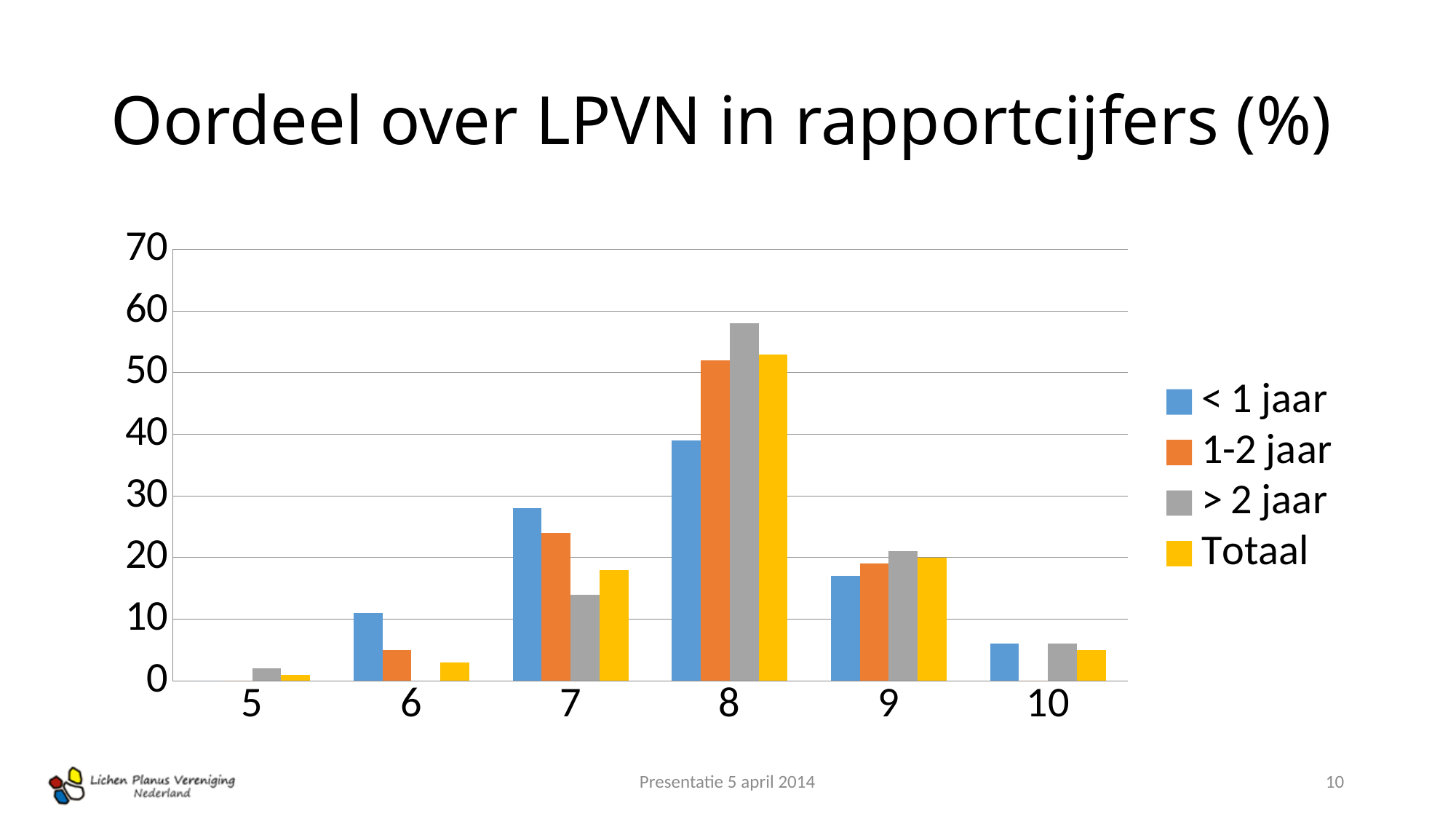
Is the value for < 1 jaar at rating 8 greater or less than 30? greater How many series does the legend list? 4 Is the value for > 2 jaar at rating 7 greater or less than 20? less Is the value for > 2 jaar at rating 8 greater or less than 50? greater At rating 7, which is larger: < 1 jaar or > 2 jaar? < 1 jaar What is the title of the chart? Oordeel over LPVN in rapportcijfers (%) Which rating has the highest Totaal value? 8 At rating 8, which series has the highest bar? > 2 jaar Which rating has the lowest Totaal value? 5 How many rating categories are shown on the x axis? 6 What kind of chart is shown on the slide? bar chart Do the Totaal values rise or fall from rating 8 to rating 10? fall